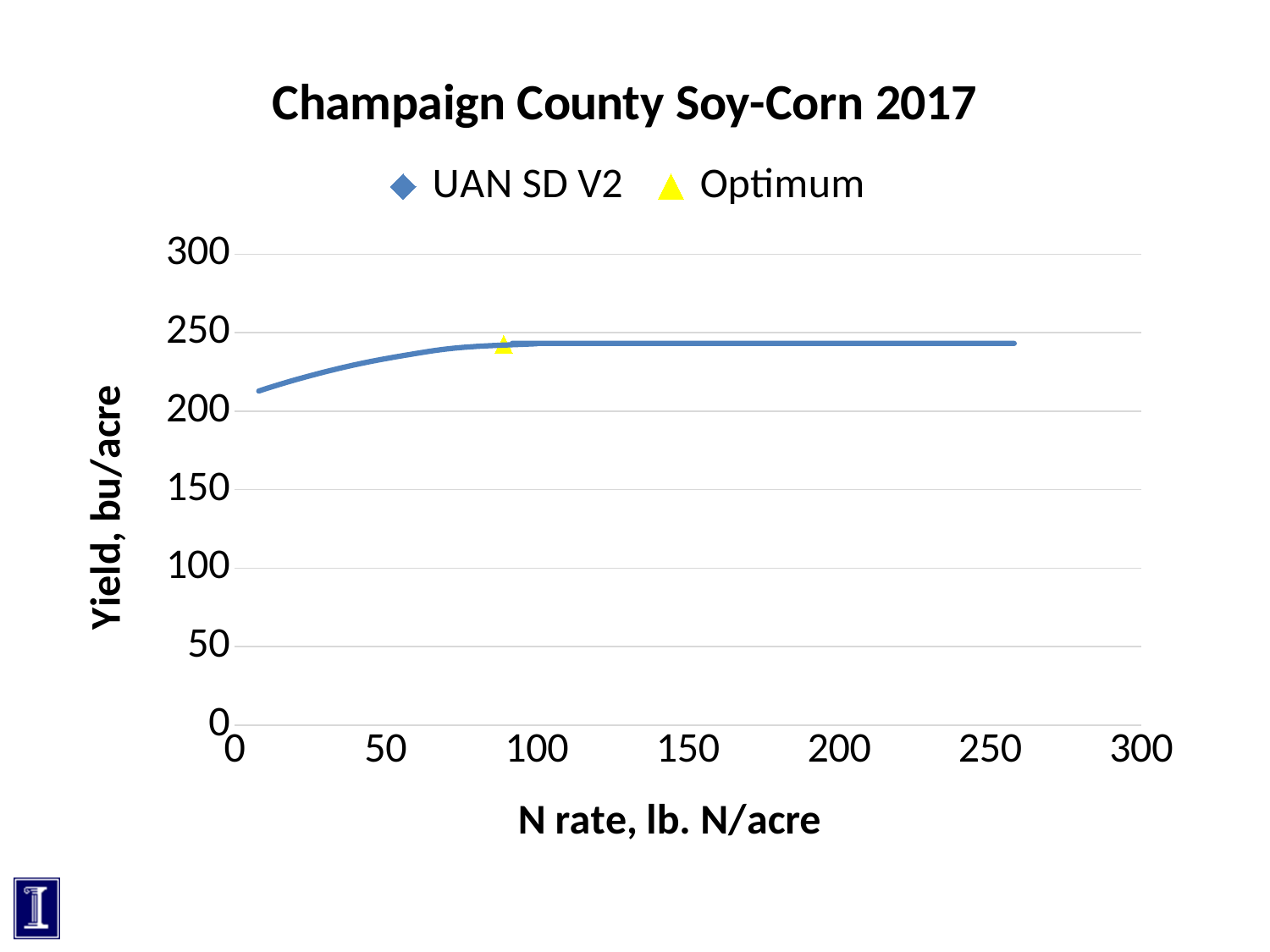
Is the lowest UAN SD V2 yield shown on the curve greater or less than 200 bu/acre? greater Is the UAN SD V2 yield at an N rate of 250 lb. N/acre greater or less than 200 bu/acre? greater What are the two series named in the legend? UAN SD V2 and Optimum What is the label of the y axis? Yield, bu/acre Is the UAN SD V2 yield at an N rate of 250 lb. N/acre greater or less than 250 bu/acre? less What is the title of the chart? Champaign County Soy-Corn 2017 Does the UAN SD V2 yield rise or fall as the N rate increases from 0 to 100 lb. N/acre? Rise How many series does the legend list? 2 What kind of chart is shown? Line chart